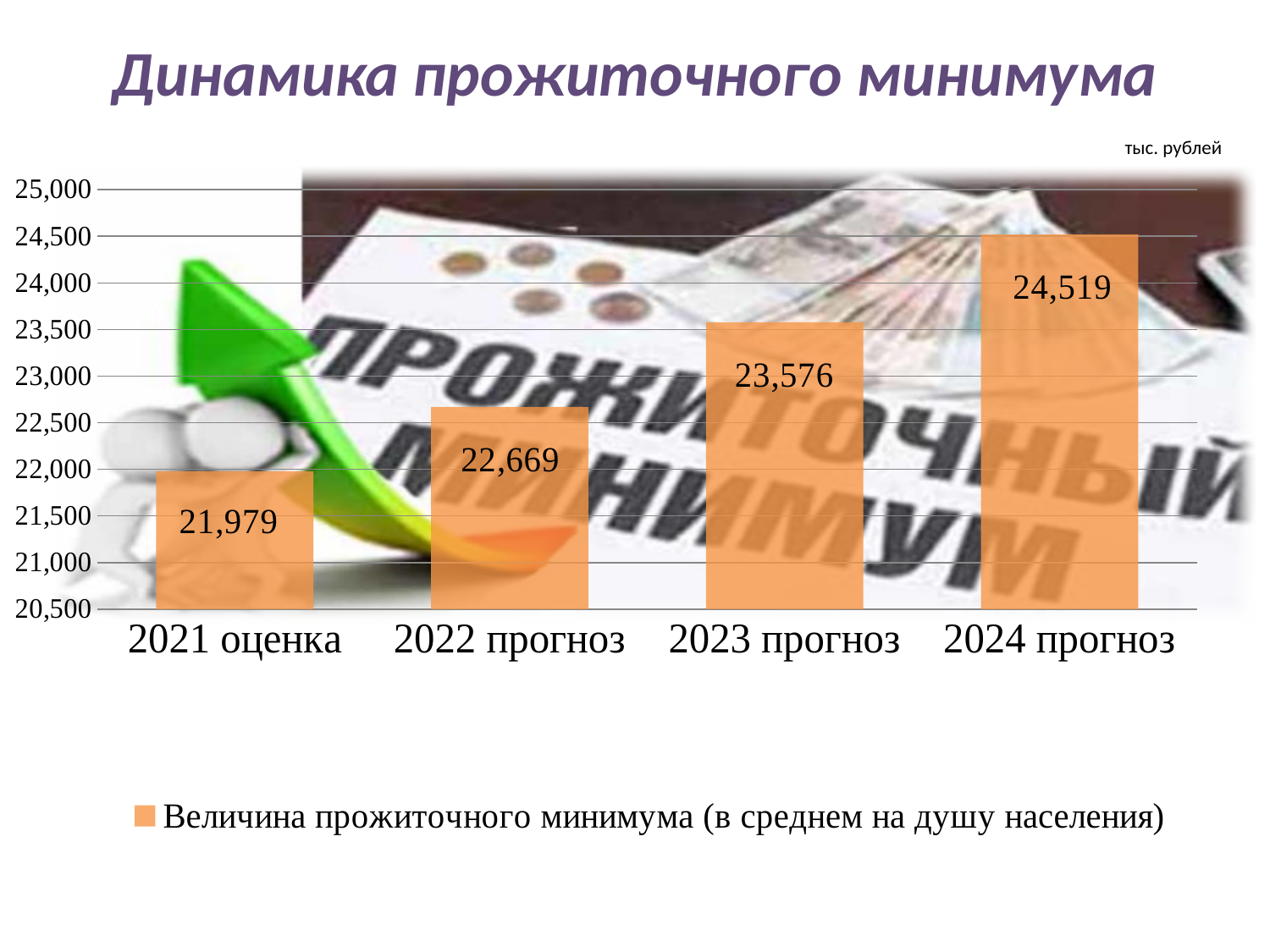
Which category has the lowest value? 2021 оценка Which category has the highest value? 2024 прогноз Is the value for 2023 прогноз greater or less than 23,000? greater What is the difference between the values for 2024 прогноз and 2021 оценка? 2,540 What kind of chart is shown on the slide? bar chart Which is larger, the value for 2022 прогноз or the value for 2023 прогноз? 2023 прогноз What is the value for 2024 прогноз? 24,519 What is the value for 2023 прогноз? 23,576 Do the values rise or fall from 2021 оценка to 2024 прогноз? rise What is the value for 2021 оценка? 21,979 How many categories are shown on the x axis? 4 What is the difference between the values for 2022 прогноз and 2021 оценка? 690